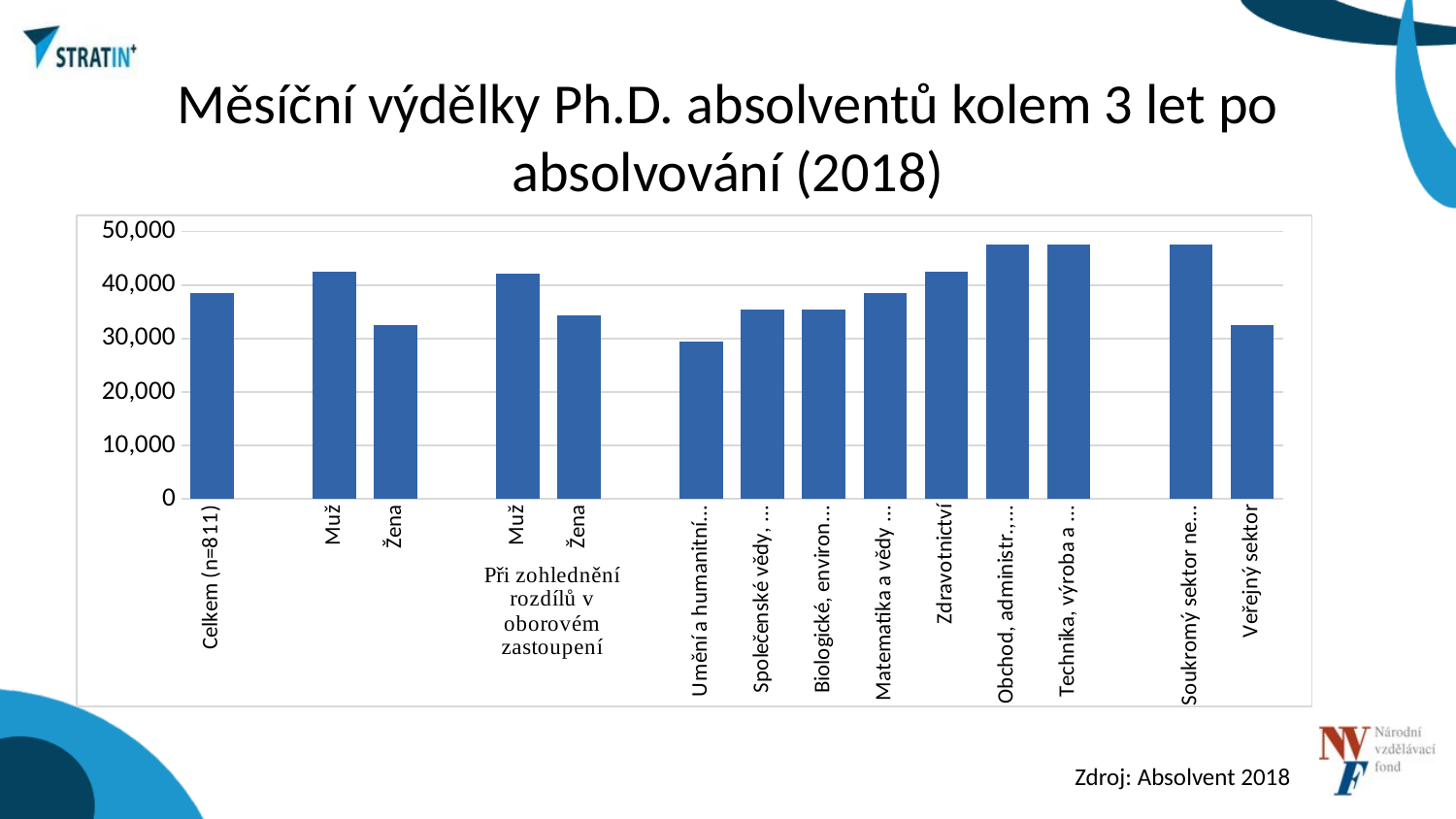
Is the value for Celkem (n=811) greater or less than 40,000? less Is the value for Zdravotnictví greater or less than 40,000? greater What is the highest value shown on the vertical axis? 50,000 What is the title of the chart? Měsíční výdělky Ph.D. absolventů kolem 3 let po absolvování (2018) Is the value for Obchod, administr... greater or less than 50,000? less Which is larger, Soukromý sektor ne... or Veřejný sektor? Soukromý sektor ne... How many bars are plotted in the chart? 14 What kind of chart is shown on the slide? bar chart Which category has the lowest bar in the chart? Umění a humanitní... Which is larger, the first Muž bar or the first Žena bar? Muž